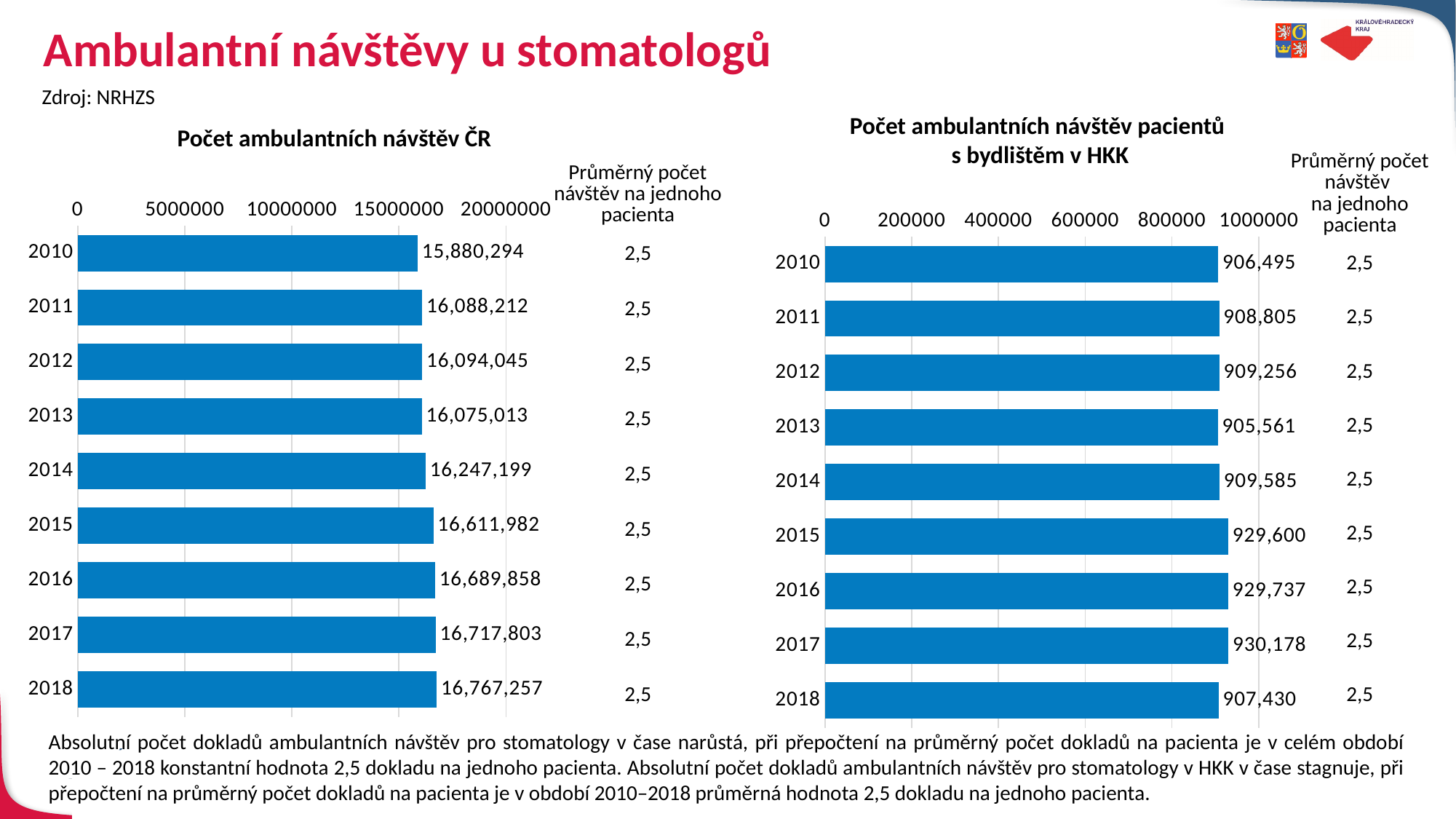
In the chart 'Počet ambulantních návštěv pacientů s bydlištěm v HKK', what is the difference between the values for 2017 and 2010? 23,683 In the chart 'Počet ambulantních návštěv ČR', which year has the highest value? 2018 In the chart 'Počet ambulantních návštěv ČR', what is the difference between the values for 2018 and 2010? 886,963 In the chart 'Počet ambulantních návštěv ČR', which year has the lowest value? 2010 In the chart 'Počet ambulantních návštěv ČR', what is the value for 2018? 16,767,257 In the chart 'Počet ambulantních návštěv pacientů s bydlištěm v HKK', what is the value for 2015? 929,600 In the chart 'Počet ambulantních návštěv ČR', which is larger, the value for 2014 or the value for 2015? 2015 In the chart 'Počet ambulantních návštěv pacientů s bydlištěm v HKK', which year has the lowest value according to the data labels? 2013 How many years are shown in the chart 'Počet ambulantních návštěv pacientů s bydlištěm v HKK'? 9 What kind of chart is 'Počet ambulantních návštěv ČR'? bar chart In the chart 'Počet ambulantních návštěv pacientů s bydlištěm v HKK', which year has the highest value according to the data labels? 2017 In the chart 'Počet ambulantních návštěv ČR', is the value for 2010 greater or less than 15000000? greater